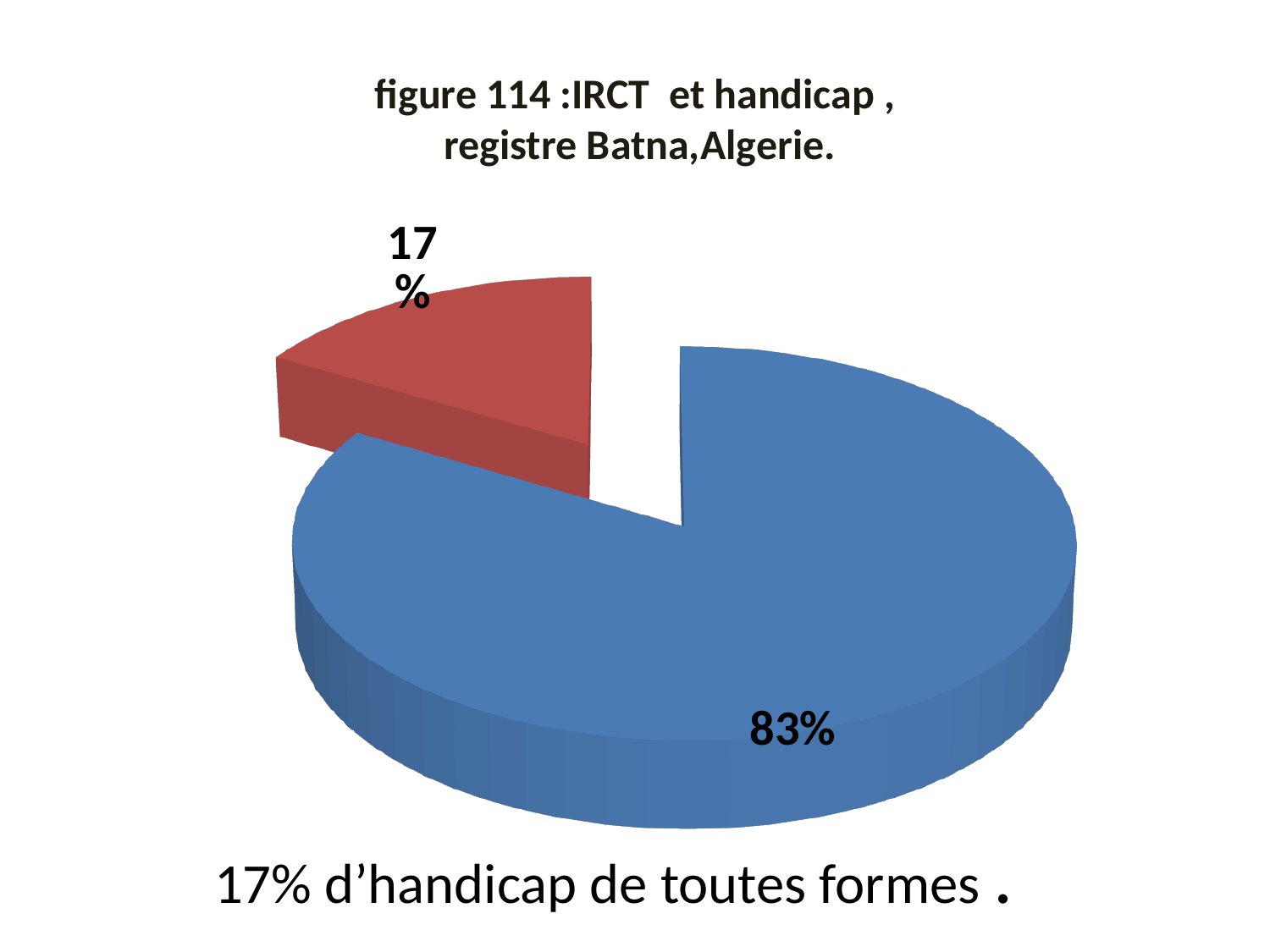
Which slice of the pie chart is the smallest? the red slice (17%) Which slice of the pie chart is the largest? the blue slice (83%) What is the difference in percentage points between the blue slice and the red slice? 66 Which is larger, the red slice or the blue slice? the blue slice How many slices does the pie chart have? 2 What kind of chart is shown on the slide? pie chart What do the two slice percentages add up to? 100% Is the share of the red slice greater or less than 20%? less Which slice is pulled out (exploded) from the pie? the red slice (17%) What share of the pie does the blue slice represent? 83% What is the title of the chart? figure 114 :IRCT et handicap , registre Batna,Algerie. What share of the pie does the red slice represent? 17%